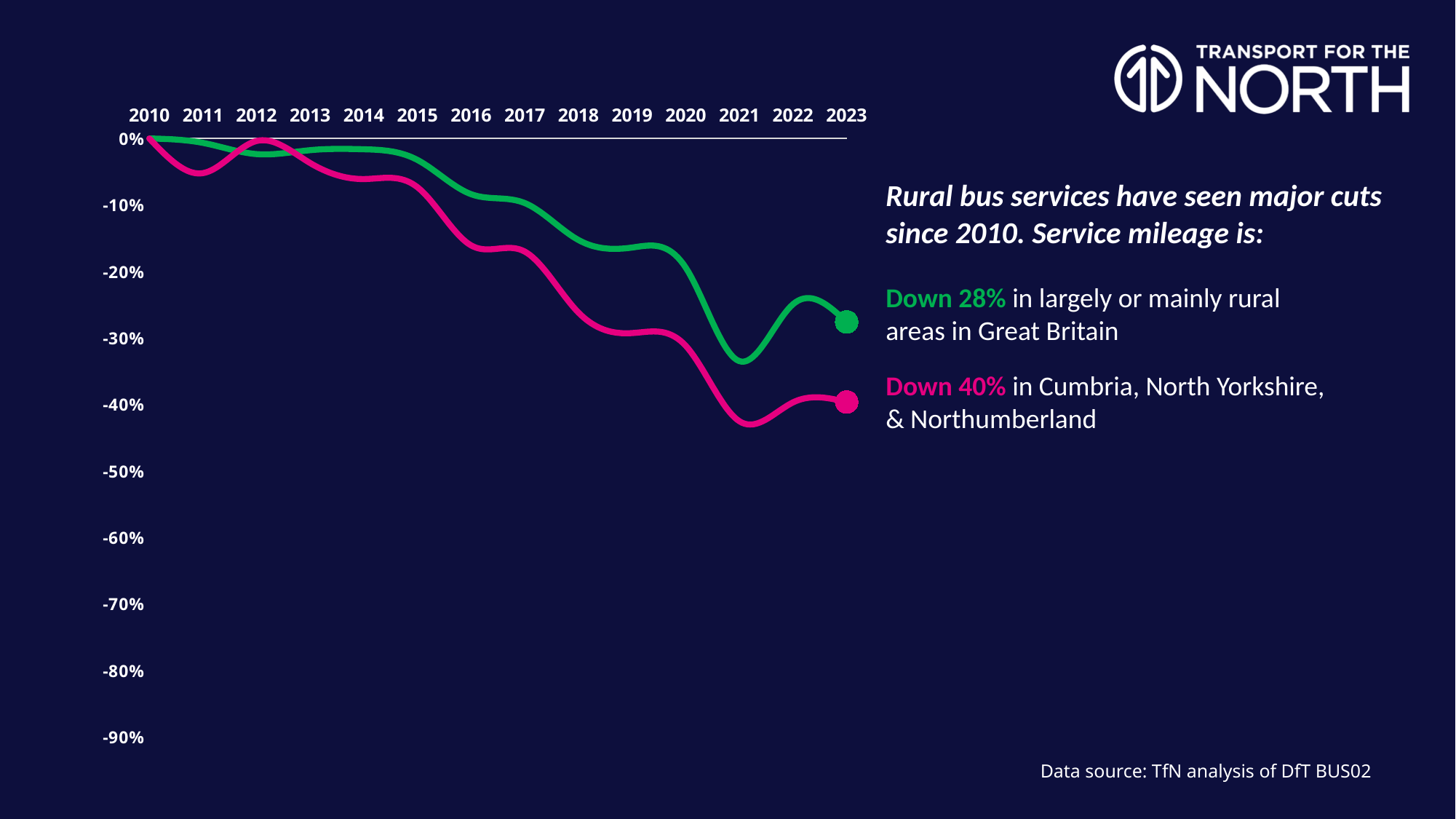
How many lines (series) are plotted on the chart? 2 What is the difference in percentage points between the decline in Cumbria, North Yorkshire & Northumberland and the decline in largely or mainly rural areas in Great Britain? 12 percentage points In which year does the pink line (Cumbria, North Yorkshire & Northumberland) reach its lowest point? 2021 By how much is service mileage down in Cumbria, North Yorkshire & Northumberland, according to the slide? 40% Is the value for the green line (largely or mainly rural areas in Great Britain) in 2019 greater or less than -20%? greater How many years are shown along the x axis of the chart? 14 What kind of chart is shown on the slide? line chart Is the value for the green line (largely or mainly rural areas in Great Britain) in 2021 greater or less than -30%? less Overall, do the lines rise or fall from 2010 to 2023? fall By how much is service mileage down in largely or mainly rural areas in Great Britain, according to the slide? 28% What colour is the line representing Cumbria, North Yorkshire & Northumberland? pink Which series shows the larger decline by 2023: largely or mainly rural areas in Great Britain, or Cumbria, North Yorkshire & Northumberland? Cumbria, North Yorkshire & Northumberland